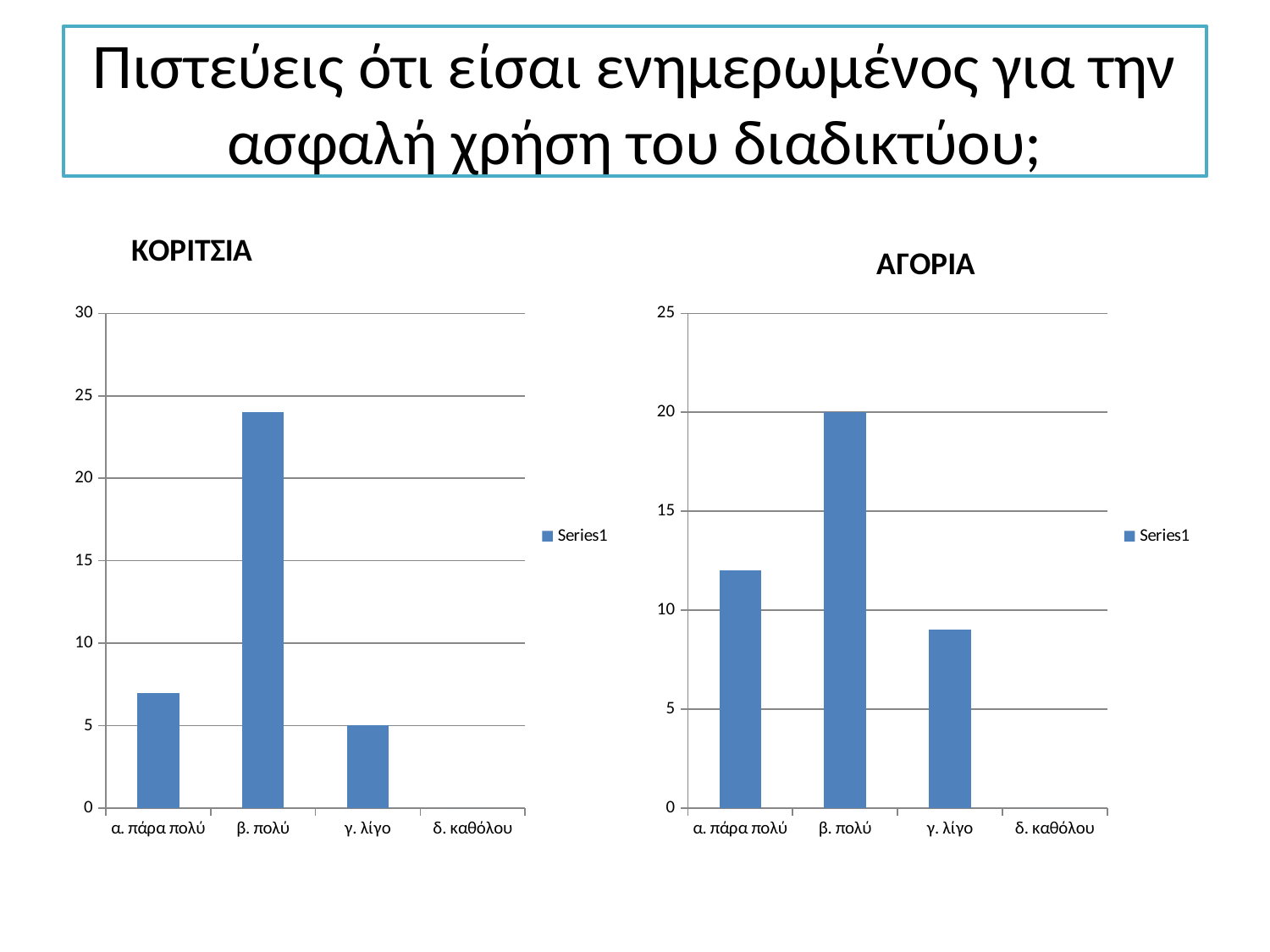
In the ΑΓΟΡΙΑ chart, which category has the highest value? β. πολύ In the ΑΓΟΡΙΑ chart, is the value for α. πάρα πολύ greater or less than 10? greater How many series does the legend of the ΚΟΡΙΤΣΙΑ chart list? 1 In the ΚΟΡΙΤΣΙΑ chart, what is the value for γ. λίγο? 5 In the ΑΓΟΡΙΑ chart, what is the value for β. πολύ? 20 In the ΚΟΡΙΤΣΙΑ chart, which is larger, the value for α. πάρα πολύ or the value for γ. λίγο? α. πάρα πολύ In the ΑΓΟΡΙΑ chart, which category has the lowest value? δ. καθόλου In the ΚΟΡΙΤΣΙΑ chart, is the value for β. πολύ greater or less than 20? greater In the ΚΟΡΙΤΣΙΑ chart, which category has the highest value? β. πολύ How many categories are shown on the x axis of the ΑΓΟΡΙΑ chart? 4 What is the title of the chart on the right side of the slide? ΑΓΟΡΙΑ What kind of chart is the ΚΟΡΙΤΣΙΑ chart? bar chart